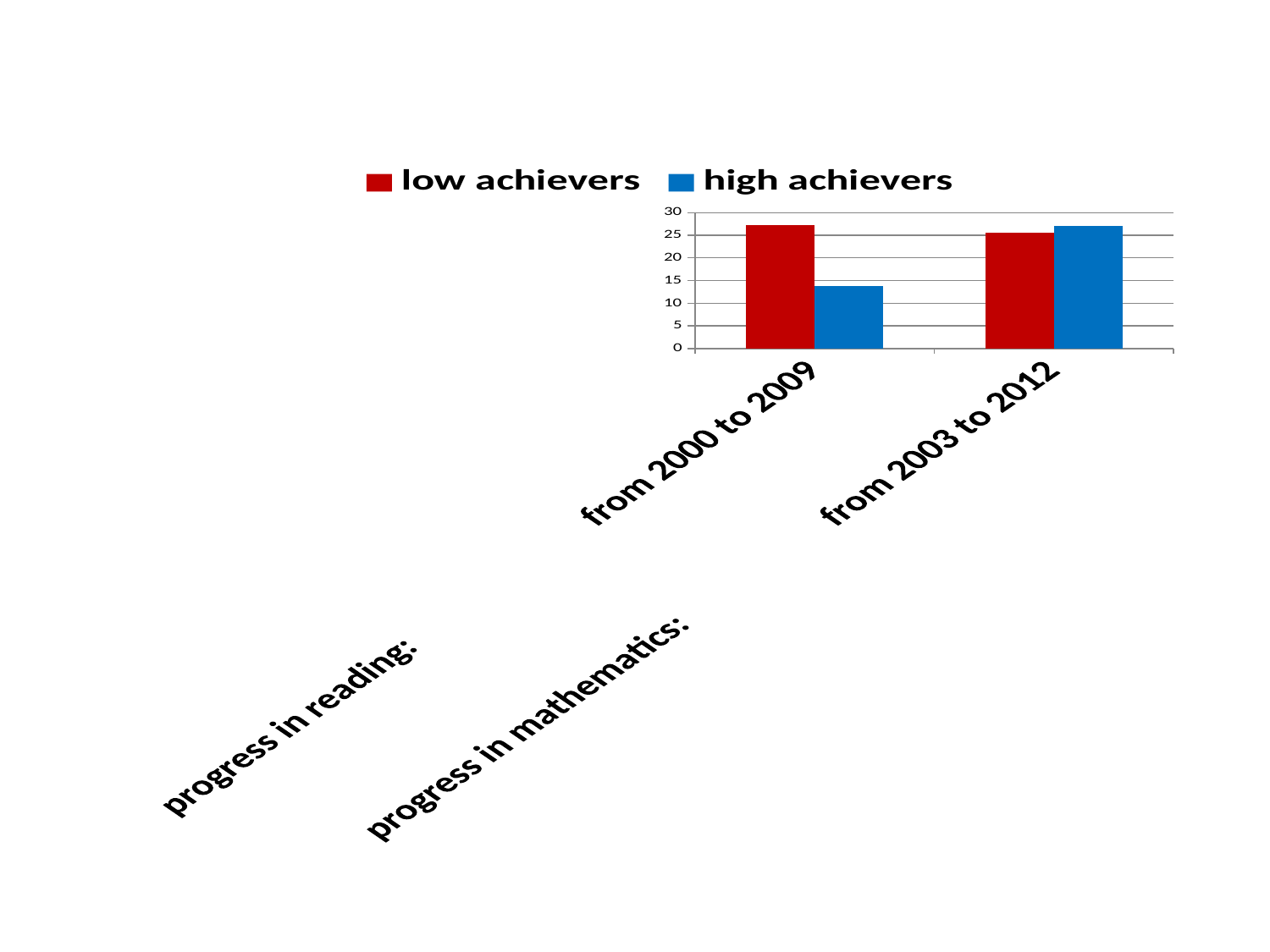
Is the value for high achievers from 2003 to 2012 greater or less than 20? greater Is the value for low achievers from 2000 to 2009 greater or less than 20? greater What is the highest value shown on the vertical axis? 30 How many series does the legend list? 2 What kind of chart is shown on the slide? bar chart Which bar has the lowest value in the chart? high achievers, from 2000 to 2009 Which series is shown in red in the legend? low achievers Is the value for high achievers from 2000 to 2009 greater or less than 20? less From 2000 to 2009, which series has the larger value, low achievers or high achievers? low achievers How many categories are shown on the x axis? 2 Does the value for high achievers rise or fall from the first category to the second? rise